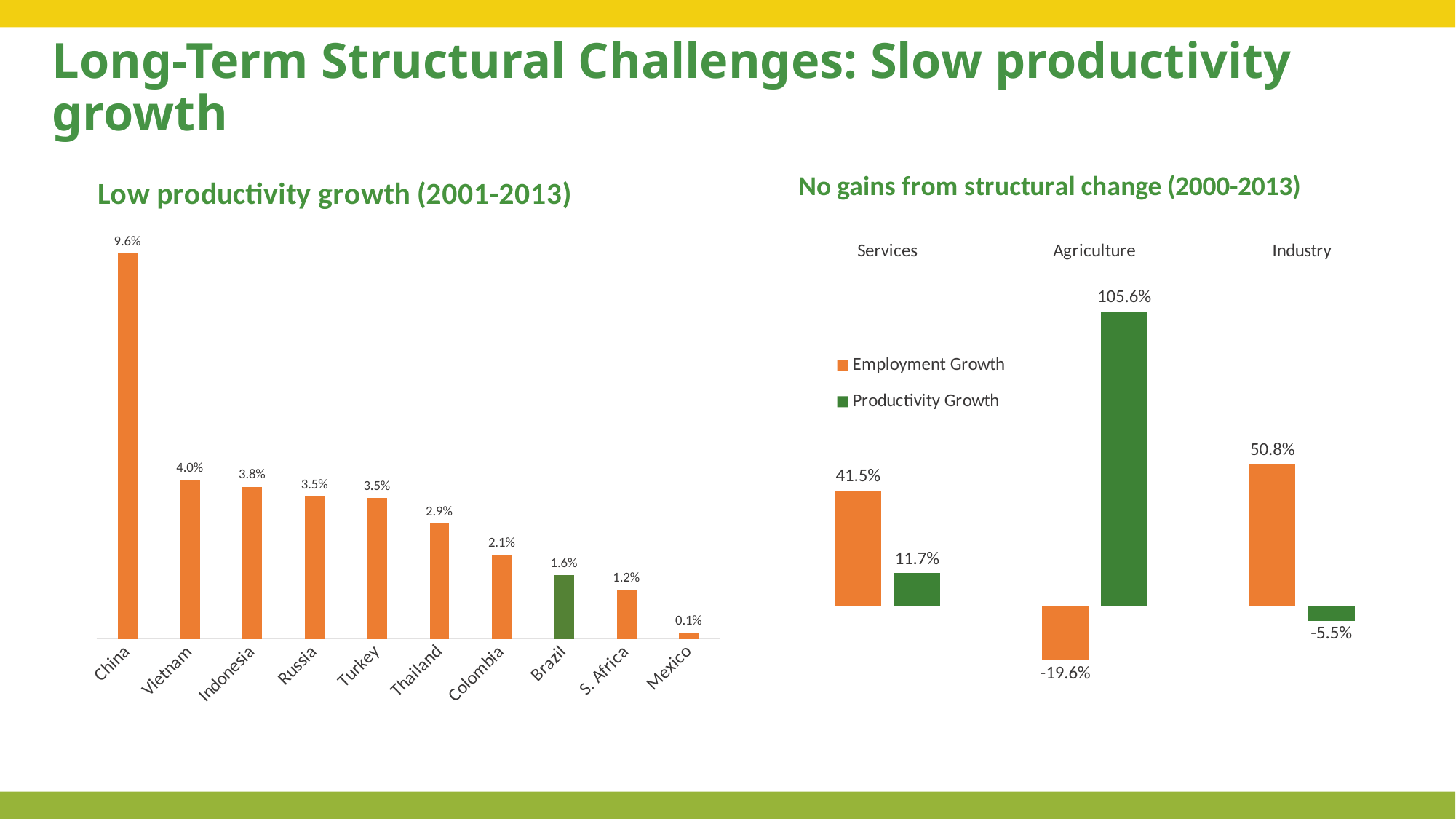
In the 'No gains from structural change (2000-2013)' chart, what is the Employment Growth value for Agriculture? -19.6% What kind of chart is the 'No gains from structural change (2000-2013)' chart? bar chart In the 'Low productivity growth (2001-2013)' chart, do the values rise or fall from left to right? fall In the 'Low productivity growth (2001-2013)' chart, what is the difference between Vietnam and Thailand? 1.1% In the 'Low productivity growth (2001-2013)' chart, what is the value for Brazil? 1.6% In the 'Low productivity growth (2001-2013)' chart, which country has the lowest value? Mexico In the 'No gains from structural change (2000-2013)' chart, how many series does the legend list? 2 In the 'No gains from structural change (2000-2013)' chart, what is the Productivity Growth value for Agriculture? 105.6% In the 'Low productivity growth (2001-2013)' chart, how many countries are shown? 10 In the 'Low productivity growth (2001-2013)' chart, what is the value for China? 9.6% In the 'Low productivity growth (2001-2013)' chart, which is larger, Colombia or S. Africa? Colombia In the 'No gains from structural change (2000-2013)' chart, what is the difference between Employment Growth and Productivity Growth for Services? 29.8%